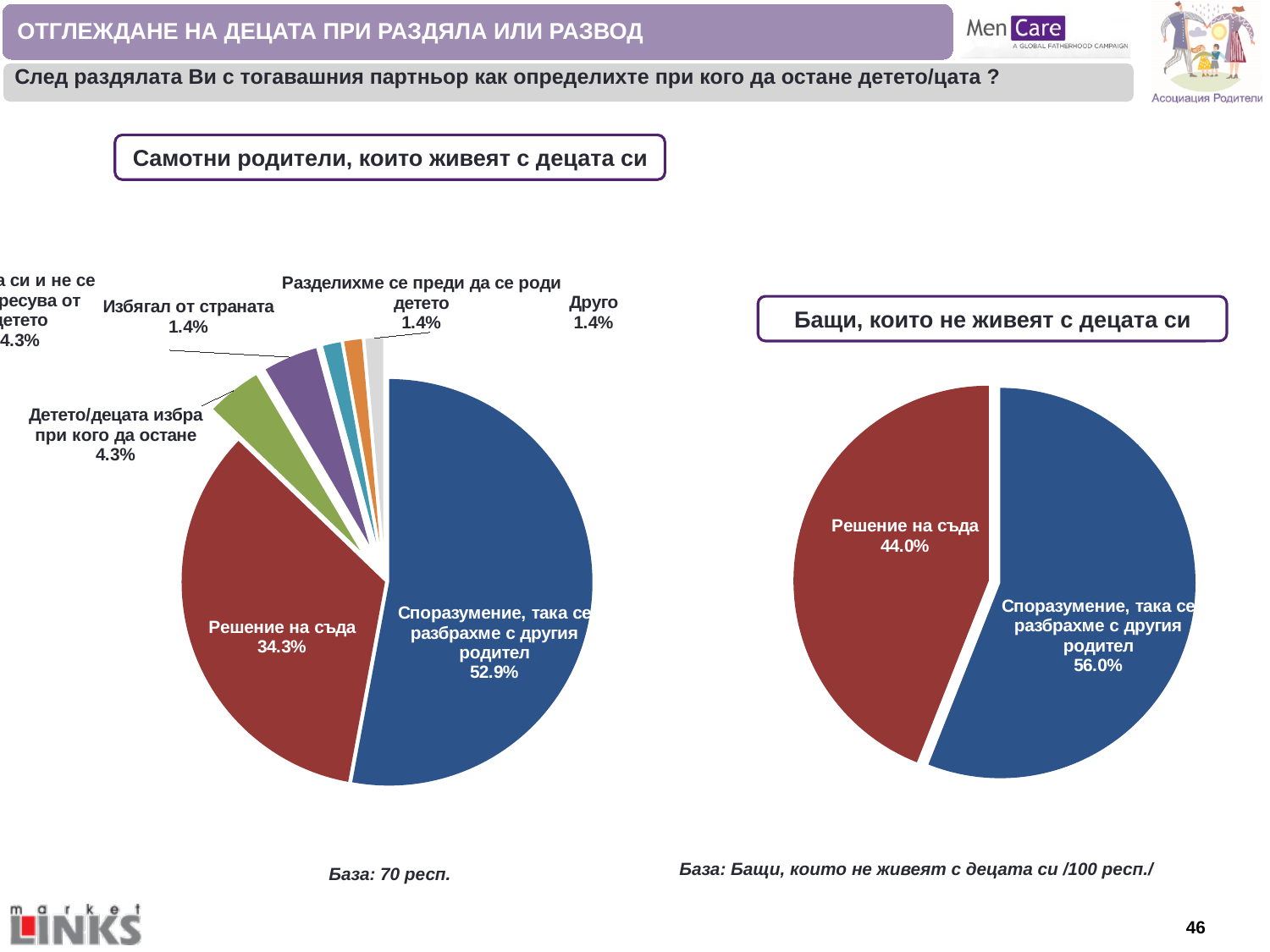
In the chart titled "Бащи, които не живеят с децата си", what share is labelled for "Споразумение, така се разбрахме с другия родител"? 56.0% In the chart titled "Самотни родители, които живеят с децата си", what share is labelled for "Споразумение, така се разбрахме с другия родител"? 52.9% In the chart titled "Самотни родители, които живеят с децата си", which slice is the largest? Споразумение, така се разбрахме с другия родител In the chart titled "Самотни родители, които живеят с децата си", what share is labelled for "Избягал от страната"? 1.4% In the chart titled "Бащи, които не живеят с децата си", what share is labelled for "Решение на съда"? 44.0% In the chart titled "Самотни родители, които живеят с децата си", what share is labelled for "Решение на съда"? 34.3% In the chart titled "Бащи, които не живеят с децата си", which of the two slices is larger? Споразумение, така се разбрахме с другия родител Which chart has the larger share for "Решение на съда": "Самотни родители, които живеят с децата си" or "Бащи, които не живеят с децата си"? Бащи, които не живеят с децата си In the chart titled "Самотни родители, които живеят с децата си", what share is labelled for "Детето/децата избра при кого да остане"? 4.3% What kind of chart is used for "Бащи, които не живеят с децата си"? Pie chart In the chart titled "Бащи, които не живеят с децата си", how many slices does the pie have? 2 In the chart titled "Самотни родители, които живеят с децата си", what is the difference between the shares for "Споразумение, така се разбрахме с другия родител" and "Решение на съда"? 18.6%